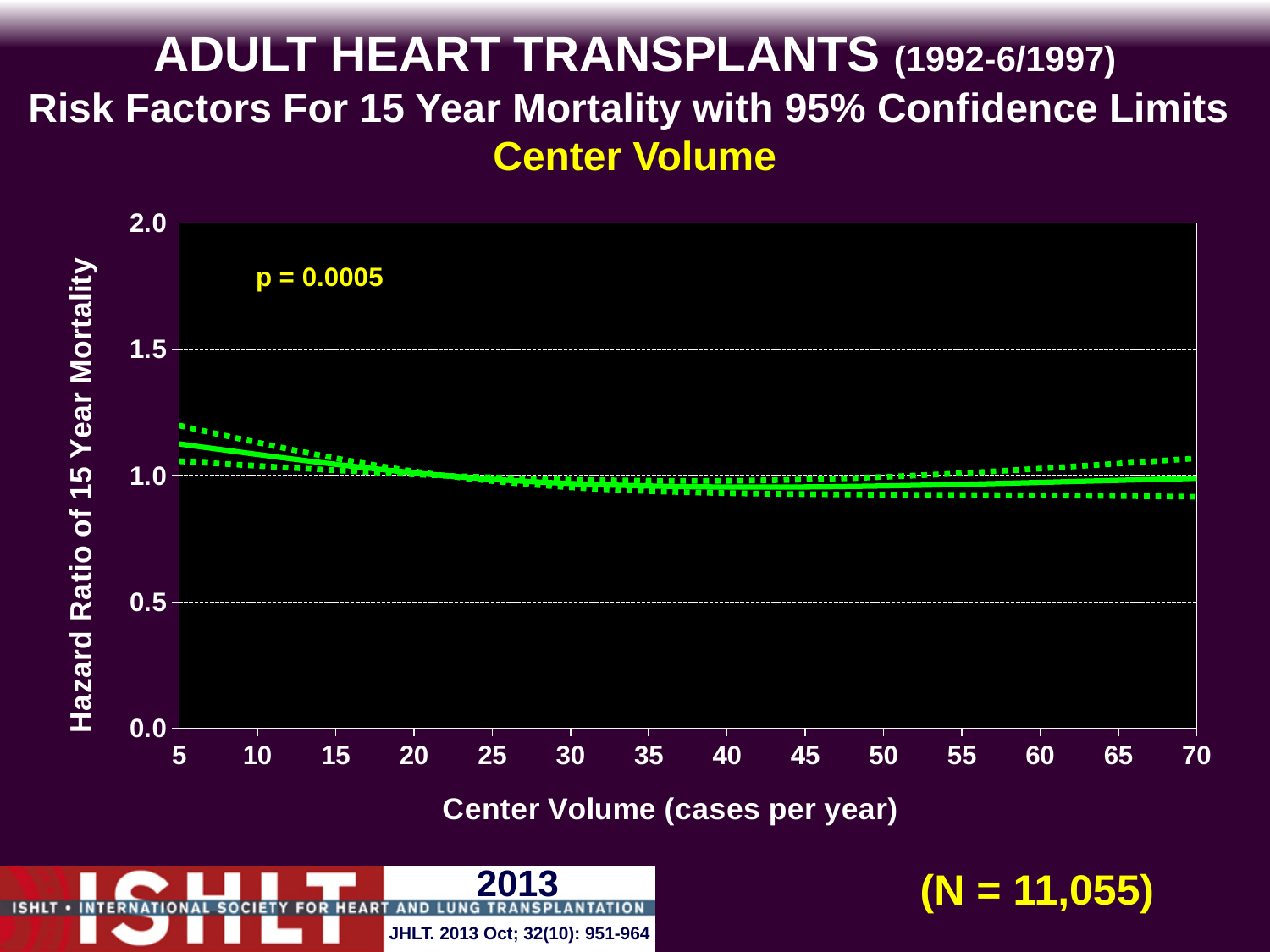
What sample size (N) is shown on the slide? N = 11,055 Which is larger, the hazard ratio at a center volume of 5 cases per year or at 40 cases per year? 5 cases per year What p-value is printed on the chart? p = 0.0005 Is the hazard ratio of 15 year mortality at a center volume of 20 cases per year greater or less than 0.5? greater How many tick marks are labelled on the x axis (Center Volume)? 14 At which center volume shown on the x axis is the hazard ratio of 15 year mortality highest? 5 Is the lower 95% confidence limit at a center volume of 40 cases per year greater or less than 1.0? less What kind of chart is shown on the slide? line chart Is the hazard ratio of 15 year mortality at a center volume of 5 cases per year greater or less than 1.5? less Does the hazard ratio of 15 year mortality rise or fall as center volume increases from 5 to 30 cases per year? fall